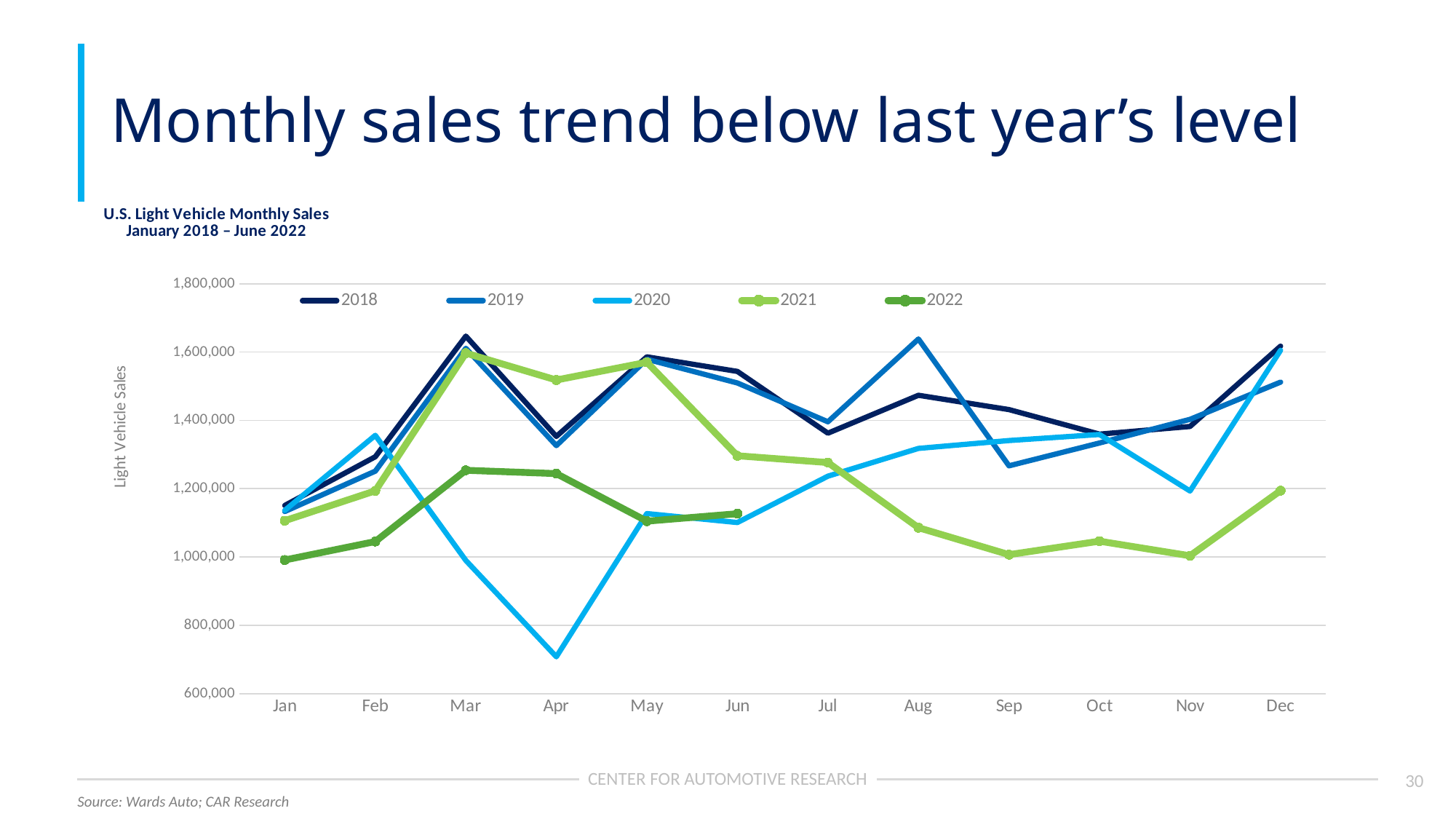
How many monthly data points are plotted for the 2022 series? 6 Is the value for 2021 in Jun greater or less than 1,400,000? less In which month does the 2019 series reach its highest value? Aug What kind of chart is shown on the slide? Line chart In which month does the 2020 series reach its lowest value? Apr Is the value for 2020 in Apr greater or less than 800,000? less Is the value for 2018 in Mar greater or less than 1,600,000? greater In which month does the 2018 series reach its highest value? Mar Which is larger in Apr, the 2020 value or the 2021 value? 2021 How many series does the legend list? 5 How many months are shown along the x axis? 12 Does the 2022 series rise or fall from Jan to Mar? Rise